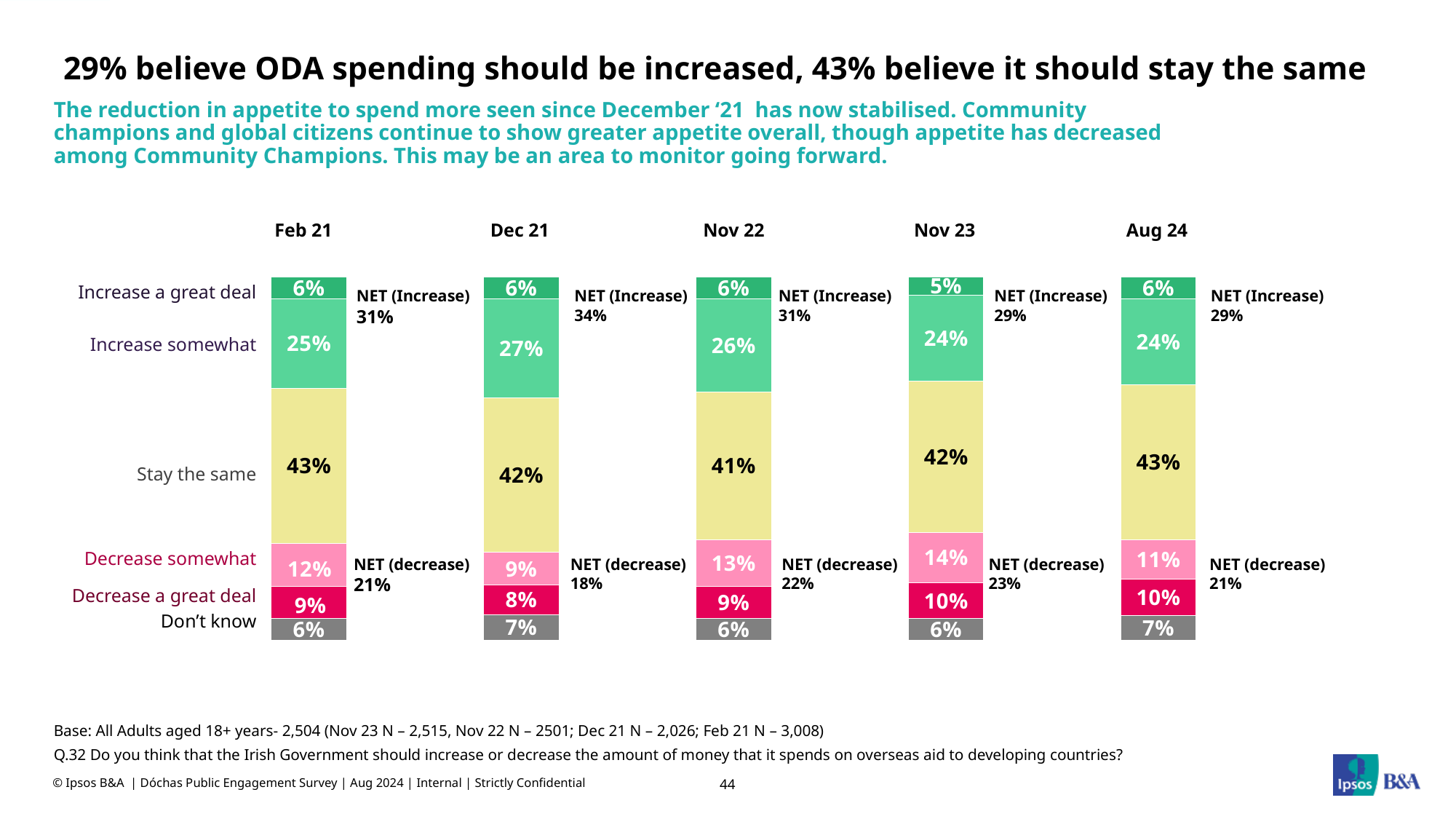
What is the 'Don't know' value in Aug 24? 7% How many survey periods are shown in the chart? 5 What is the 'Decrease somewhat' value for Nov 23? 14% What percentage of respondents said ODA spending should 'Stay the same' in Nov 22? 41% What type of chart is shown on the slide? Stacked bar chart What is the NET (Increase) figure shown for Dec 21? 34% Which is larger: the 'Increase somewhat' value for Feb 21 or for Nov 22? Nov 22 In which survey period is the 'Increase somewhat' value highest? Dec 21 What is the value for 'Increase somewhat' in Dec 21? 27% What colour is used for the 'Stay the same' segment of the bars? Yellow In which survey period is the 'Decrease a great deal' value lowest? Dec 21 What is the difference in percentage points between the 'Stay the same' values for Feb 21 and Nov 22? 2 percentage points